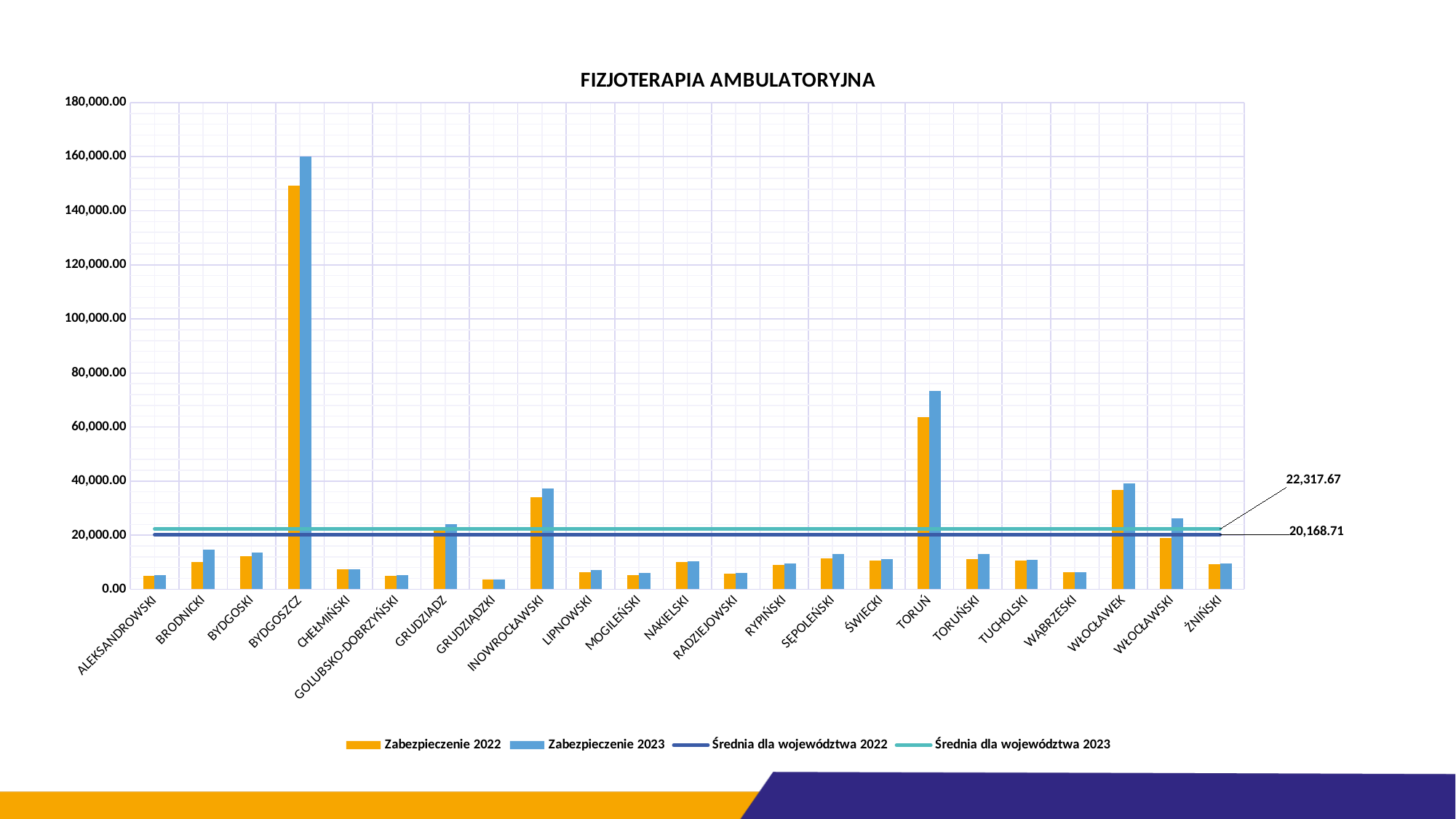
Which category has the highest Zabezpieczenie 2023 value? BYDGOSZCZ Is the Zabezpieczenie 2023 value for TORUŃ greater or less than 60,000.00? greater What is the title of the chart? FIZJOTERAPIA AMBULATORYJNA Which category has the lowest Zabezpieczenie 2022 value? GRUDZIĄDZKI What is the difference between Średnia dla województwa 2023 and Średnia dla województwa 2022? 2,148.96 Is the Zabezpieczenie 2022 value for WŁOCŁAWEK greater or less than 40,000.00? less What is the value of Średnia dla województwa 2022 shown on the chart? 20,168.71 How many series does the legend list? 4 Which is larger for TORUŃ: Zabezpieczenie 2022 or Zabezpieczenie 2023? Zabezpieczenie 2023 Is the Zabezpieczenie 2023 value for BYDGOSZCZ greater or less than 140,000.00? greater What is the value of Średnia dla województwa 2023 shown on the chart? 22,317.67 How many categories are shown on the x axis? 23